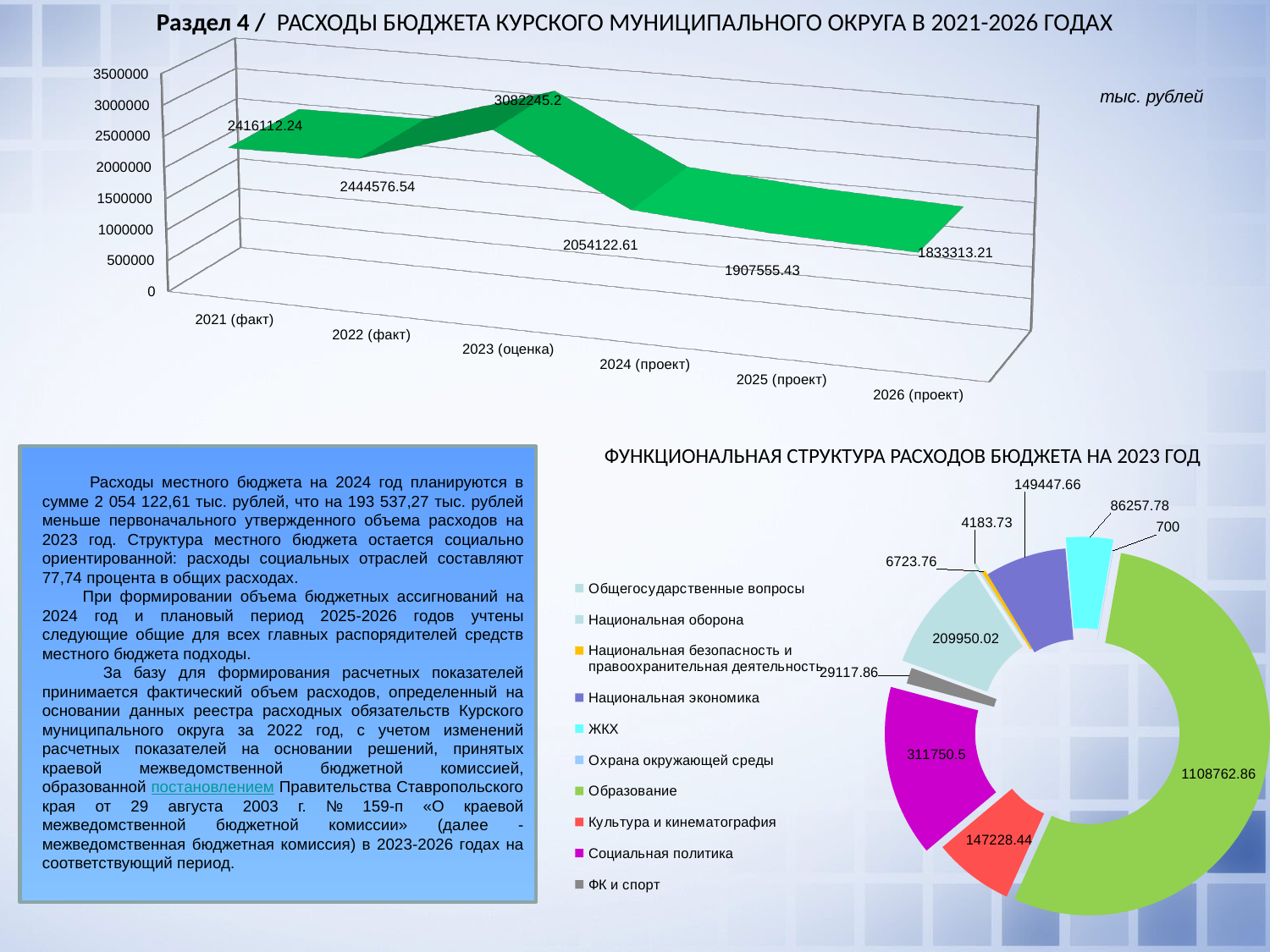
How many years are plotted in the top chart? 6 In the doughnut chart 'Функциональная структура расходов бюджета на 2023 год', which category has the largest value? Образование In the top chart, what is the difference between the values for 2023 (оценка) and 2024 (проект)? 1028122.59 In the top chart, what is the value for 2023 (оценка)? 3082245.2 In the top chart, what unit is indicated for the values? тыс. рублей In the top chart, do the values rise or fall from 2023 (оценка) to 2026 (проект)? fall In the top chart, which year has the lowest value? 2026 (проект) In the top chart, what is the value for 2026 (проект)? 1833313.21 What kind of chart is the top chart showing budget expenditures for 2021-2026? 3D line chart In the top chart, which year has the highest value? 2023 (оценка) In the doughnut chart 'Функциональная структура расходов бюджета на 2023 год', what is the value for Образование? 1108762.86 In the doughnut chart 'Функциональная структура расходов бюджета на 2023 год', how many categories does the legend list? 10